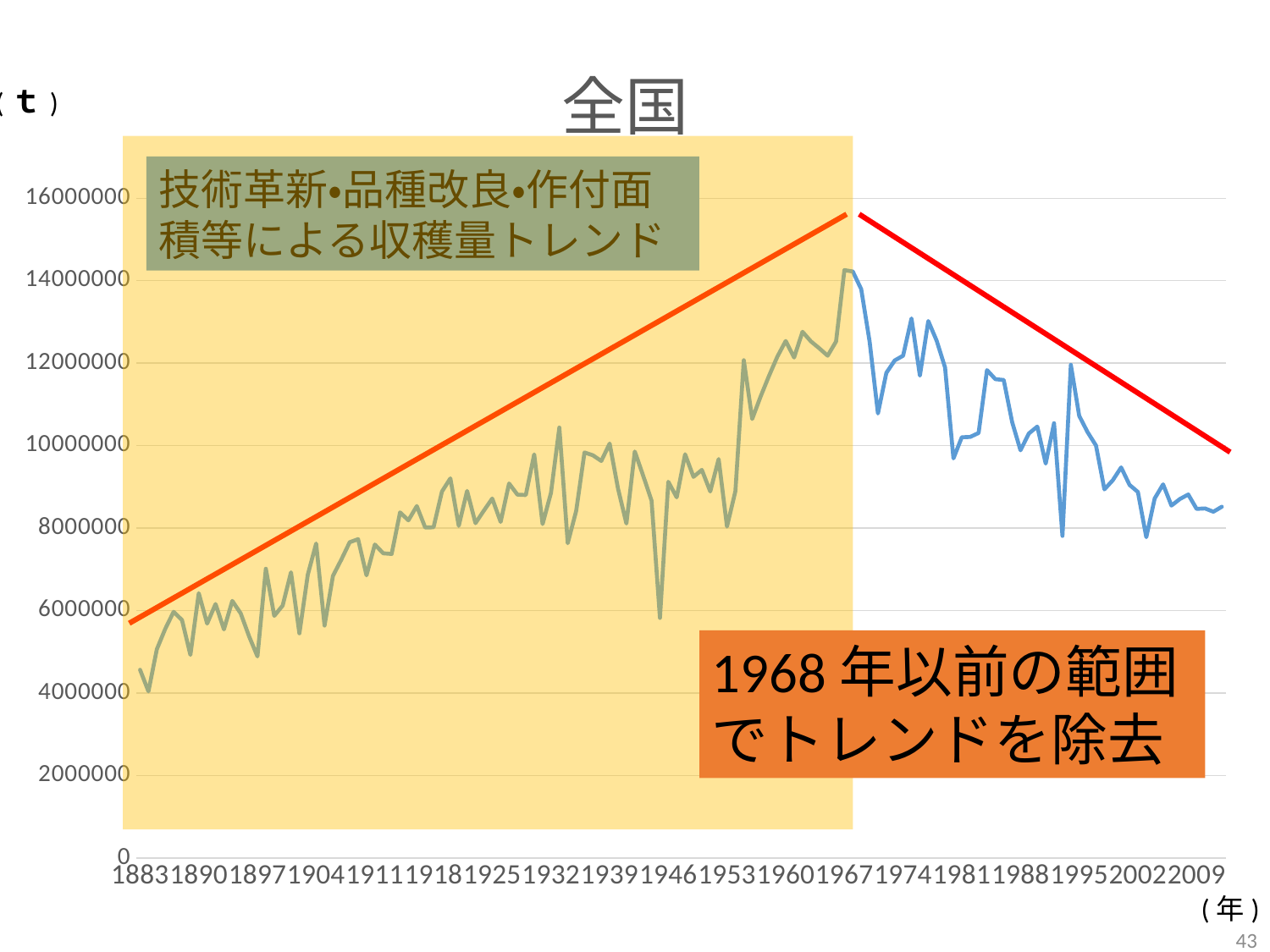
Is the value for 1883 greater or less than 6000000? less What is the highest value shown on the y axis? 16000000 Is the value for 2009 greater or less than 10000000? less Does the plotted line generally rise or fall from 1883 to 1967? rise What is the title of the chart? 全国 Does the plotted line generally rise or fall from 1967 to 2009? fall What kind of chart is shown on the slide? line chart How many year labels are shown on the x axis? 19 Is the value for 1883 greater or less than 2000000? greater What unit is shown on the y axis of the chart? t Which is larger, the value around 1967 or the value for 2009? the value around 1967